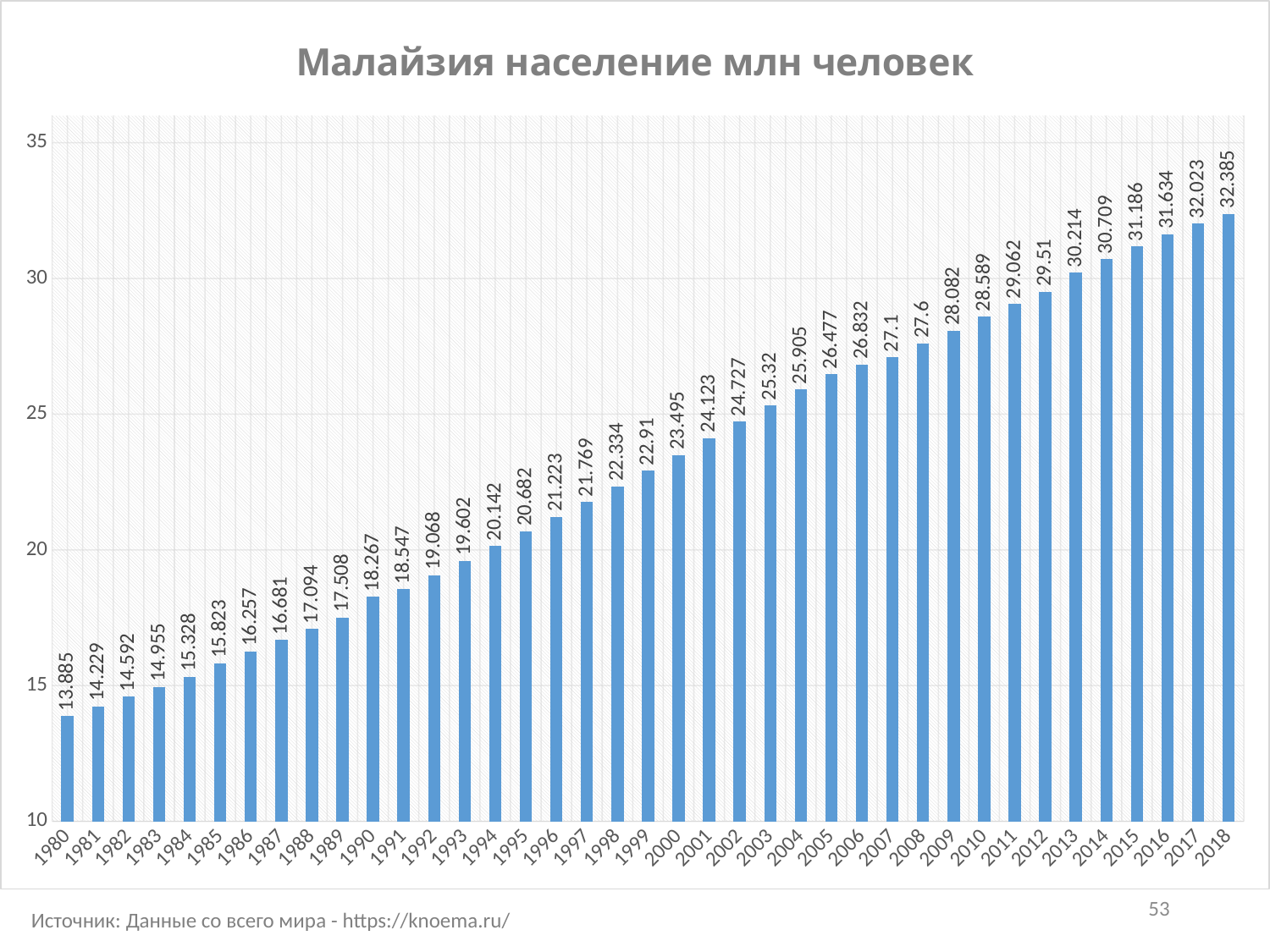
What is the difference between the population values for 2018 and 1980? 18.5 Is the value for 1985 greater or less than 20? less How many years (bars) are shown on the chart? 39 What is the population value shown for 1980? 13.885 Which year has the lowest population value? 1980 What is the population value shown for 2018? 32.385 What kind of chart is shown on the slide? bar chart What is the difference between the population values for 2000 and 1990? 5.228 What is the population value shown for 2000? 23.495 Which is larger, the value for 1995 or the value for 2005? 2005 Which year has the highest population value? 2018 What is the population value shown for 2010? 28.589